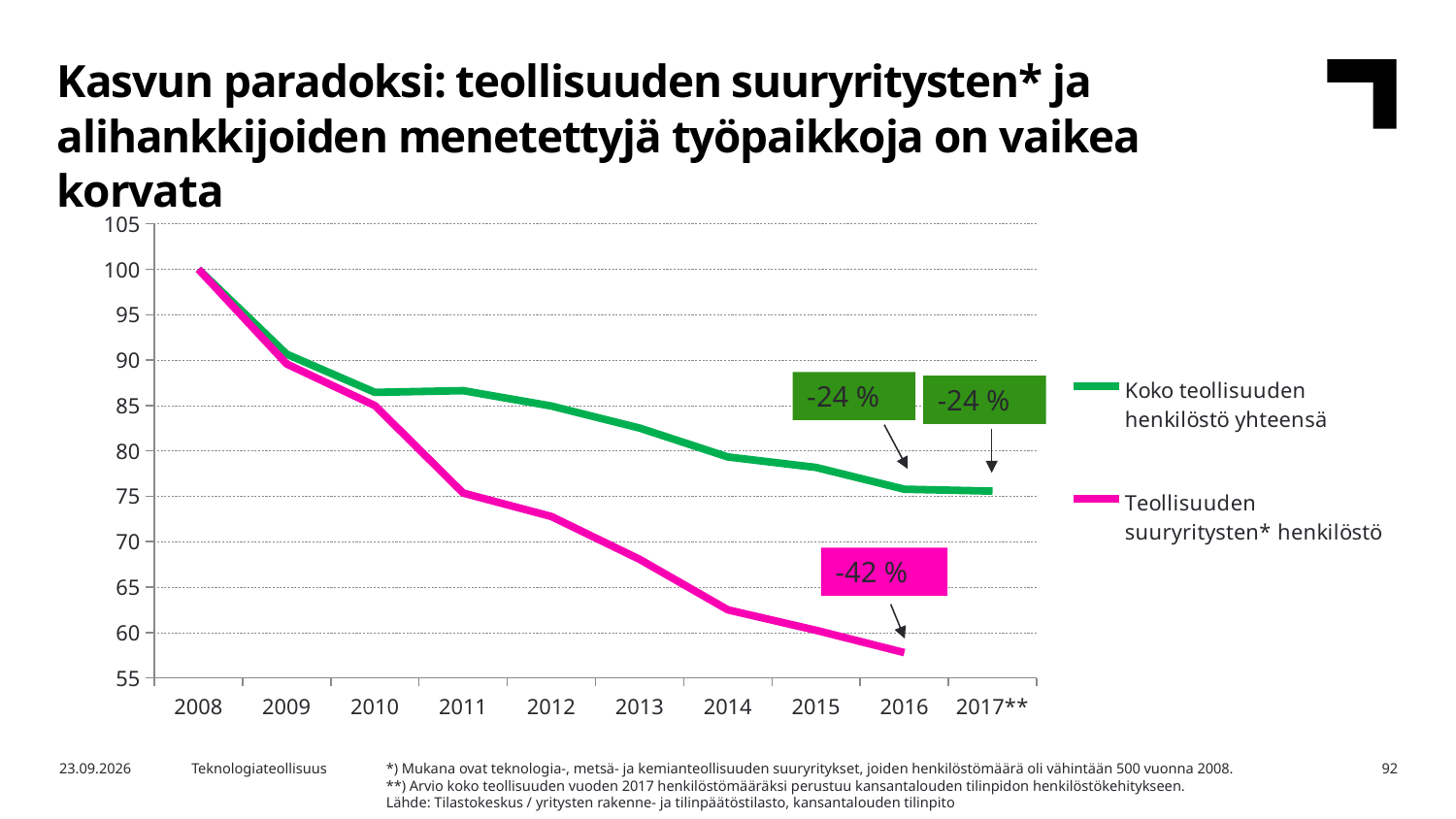
What kind of chart is shown on the slide? line chart In 2016, which series has the higher value: Koko teollisuuden henkilöstö yhteensä or Teollisuuden suuryritysten* henkilöstö? Koko teollisuuden henkilöstö yhteensä How many series does the legend list? 2 What is the value of both series in 2008? 100 What colour is the Koko teollisuuden henkilöstö yhteensä line? green What percentage change is labelled for the Koko teollisuuden henkilöstö yhteensä line at 2016? -24 % Is the value for Teollisuuden suuryritysten* henkilöstö in 2012 greater or less than 75? less In which year does the Teollisuuden suuryritysten* henkilöstö line reach its lowest value? 2016 How many years are shown on the x axis? 10 Is the value for Teollisuuden suuryritysten* henkilöstö in 2016 greater or less than 60? less What percentage change is labelled for the Teollisuuden suuryritysten* henkilöstö line at 2016? -42 % Do the values of the Teollisuuden suuryritysten* henkilöstö line rise or fall from 2008 to 2016? fall